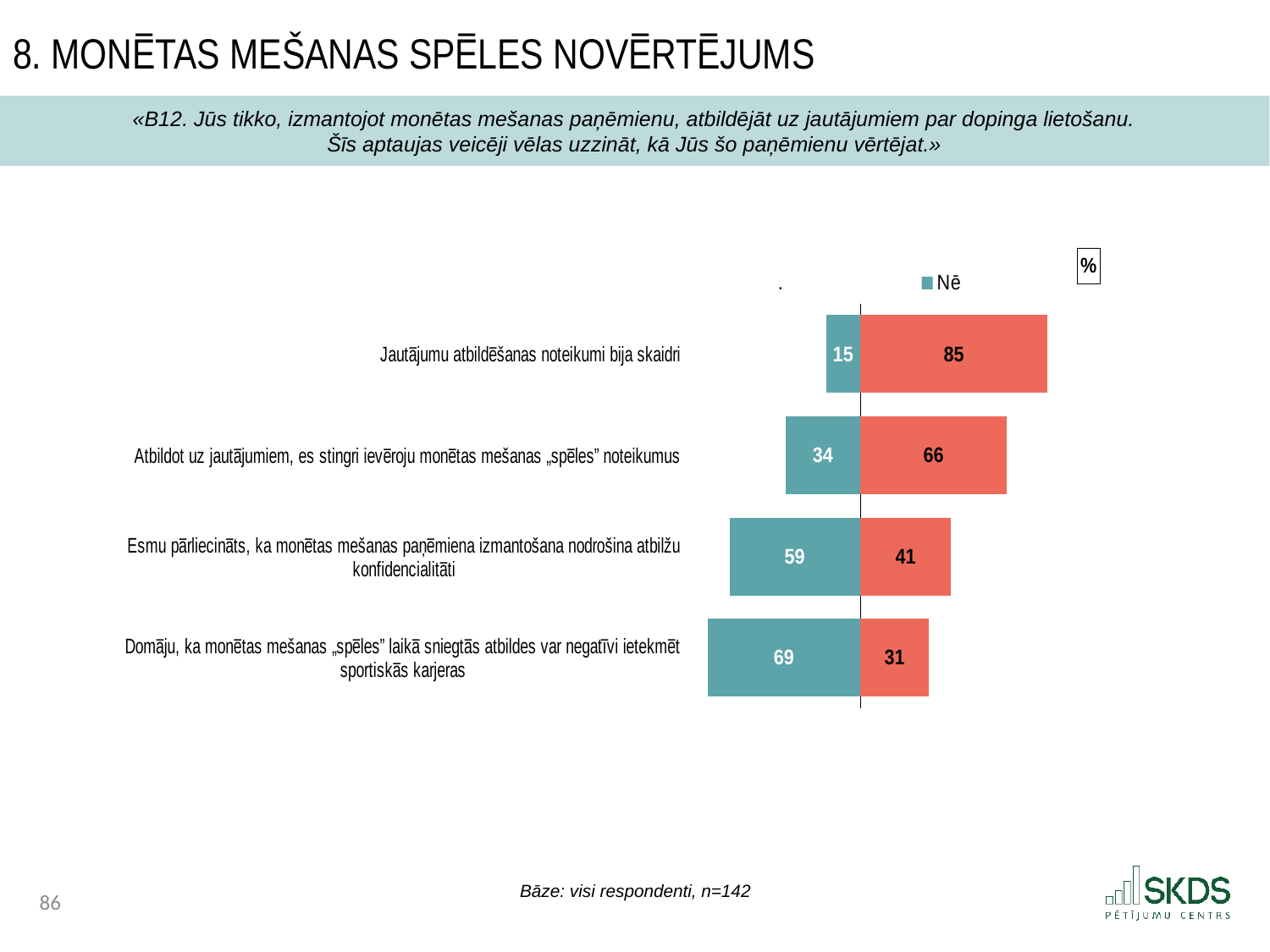
What is the "Nē" value for "Atbildot uz jautājumiem, es stingri ievēroju monētas mešanas „spēles” noteikumus"? 34 What is the value of the red bar for "Esmu pārliecināts, ka monētas mešanas paņēmiena izmantošana nodrošina atbilžu konfidencialitāti"? 41 What is the "Nē" value for "Domāju, ka monētas mešanas „spēles” laikā sniegtās atbildes var negatīvi ietekmēt sportiskās karjeras"? 69 How many statements (categories) are shown in the chart? 4 What is the "Nē" value for "Jautājumu atbildēšanas noteikumi bija skaidri"? 15 For "Esmu pārliecināts, ka monētas mešanas paņēmiena izmantošana nodrošina atbilžu konfidencialitāti", which is larger: the "Nē" value or the red bar value? Nē What type of chart is shown on the slide? bar chart What is the value of the red bar for "Jautājumu atbildēšanas noteikumi bija skaidri"? 85 Which statement has the highest "Nē" value? Domāju, ka monētas mešanas „spēles” laikā sniegtās atbildes var negatīvi ietekmēt sportiskās karjeras Which statement has the lowest "Nē" value? Jautājumu atbildēšanas noteikumi bija skaidri What colour are the "Nē" bars in the chart? teal What is the difference between the red bar value and the "Nē" value for "Jautājumu atbildēšanas noteikumi bija skaidri"? 70